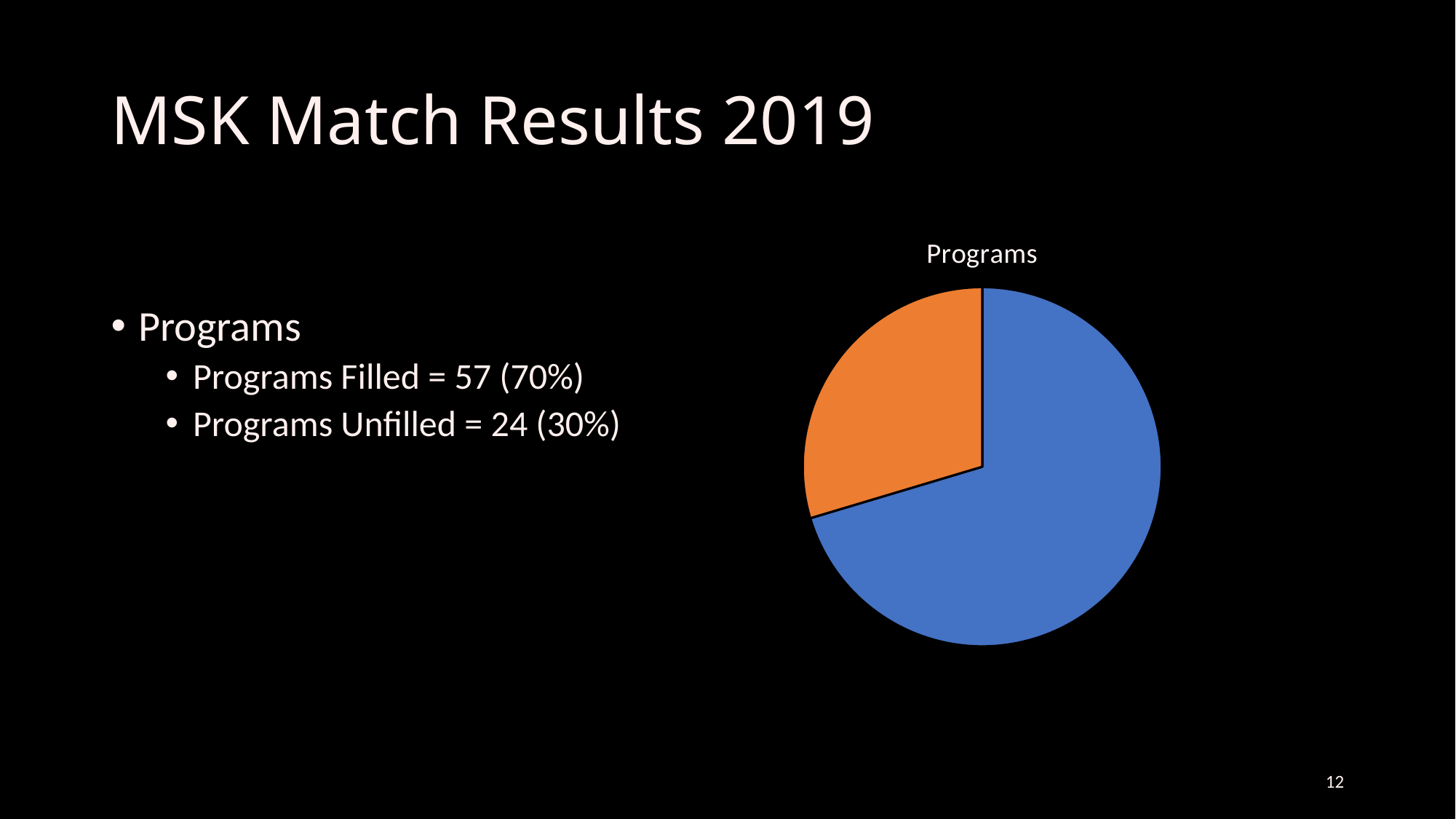
What share of programs were unfilled? 30% Which is larger, the number of programs filled or programs unfilled? Programs Filled What is the difference between the number of programs filled and programs unfilled? 33 What is the total number of programs represented in the pie chart? 81 What share of programs were filled? 70% What colour is the larger slice of the pie chart? blue Which slice of the pie is the largest? Programs Filled According to the slide, how many programs were unfilled? 24 What is the title of the chart? Programs According to the slide, how many programs were filled? 57 What kind of chart is shown on the slide? pie chart How many slices does the pie chart have? 2